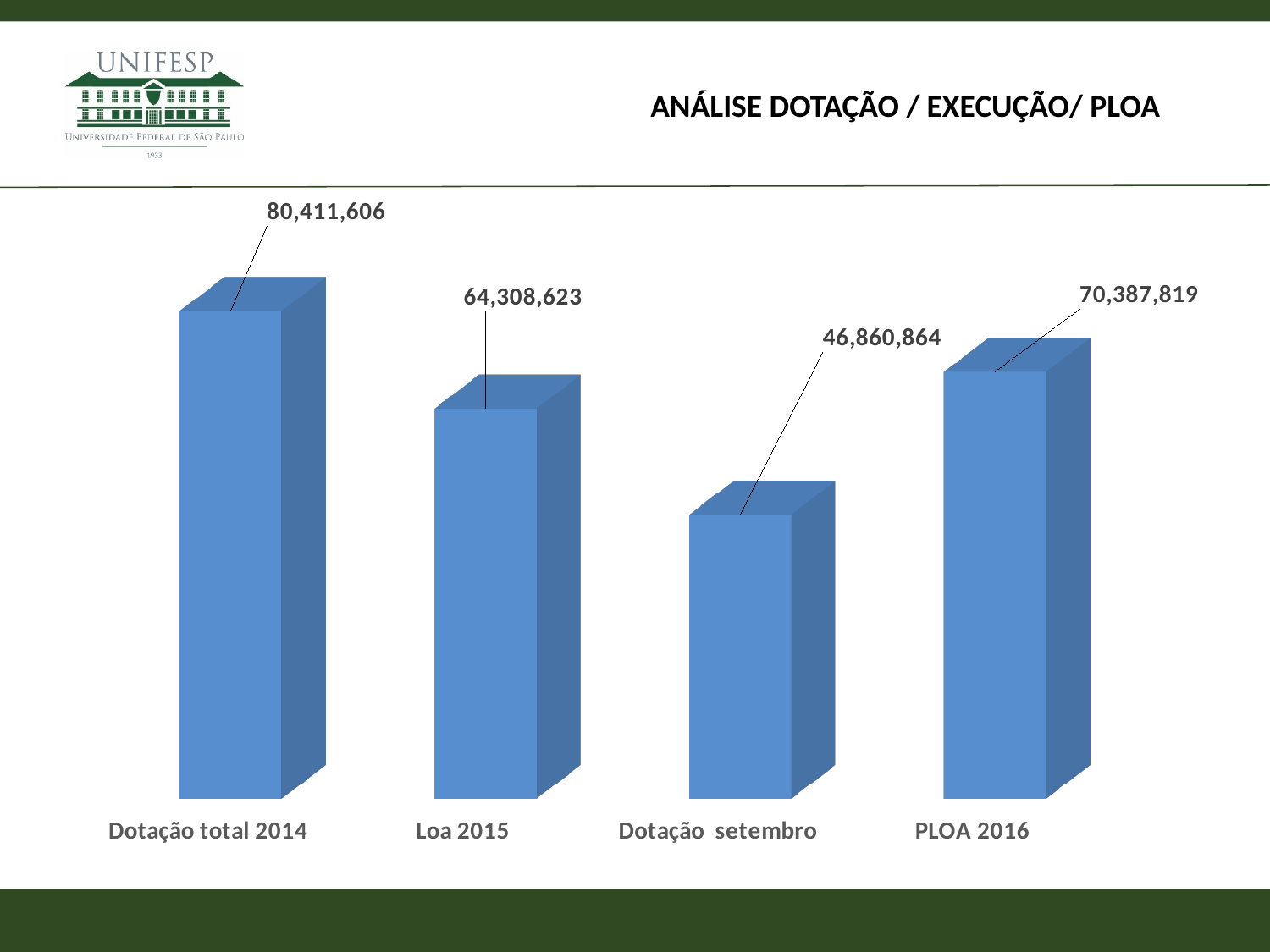
What is the title shown on the slide above the chart? ANÁLISE DOTAÇÃO / EXECUÇÃO/ PLOA How many categories are shown in the chart? 4 What kind of chart is shown on the slide? Bar chart Which category has the lowest value? Dotação setembro Which category has the highest value? Dotação total 2014 What is the value for Loa 2015? 64,308,623 What is the difference between Dotação total 2014 and Loa 2015? 16,102,983 What is the value for PLOA 2016? 70,387,819 Which is larger, Loa 2015 or PLOA 2016? PLOA 2016 What is the value for Dotação setembro? 46,860,864 What is the value for Dotação total 2014? 80,411,606 What is the difference between PLOA 2016 and Dotação setembro? 23,526,955